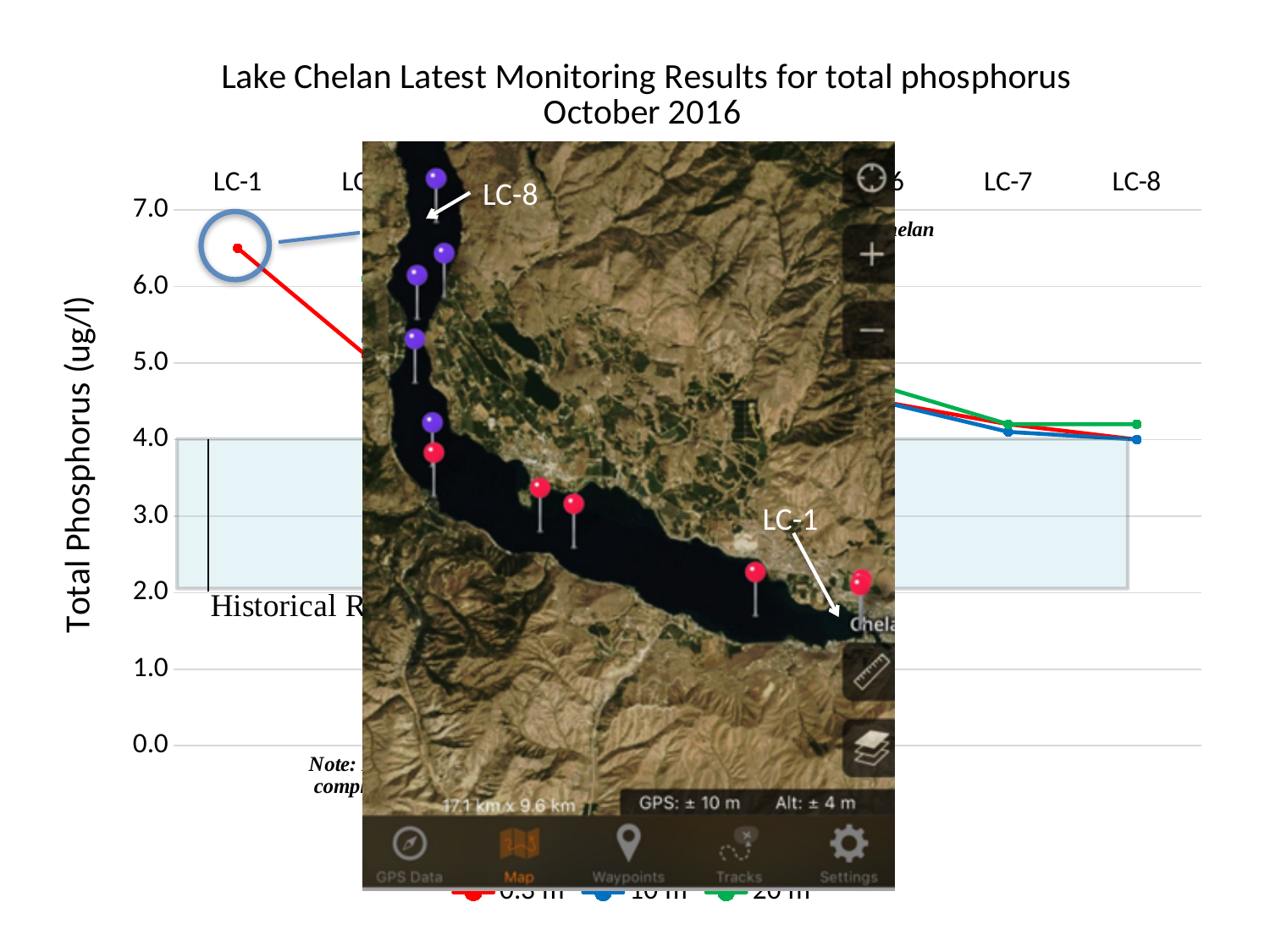
What kind of chart is shown on the slide? line chart How many series does the chart legend list? 3 Is the 20 m value at LC-8 greater or less than 3.0? greater Is the 20 m value at LC-7 greater or less than 5.0? less What is the label on the vertical axis of the chart? Total Phosphorus (ug/l) Which colour represents the 20 m series in the legend? green